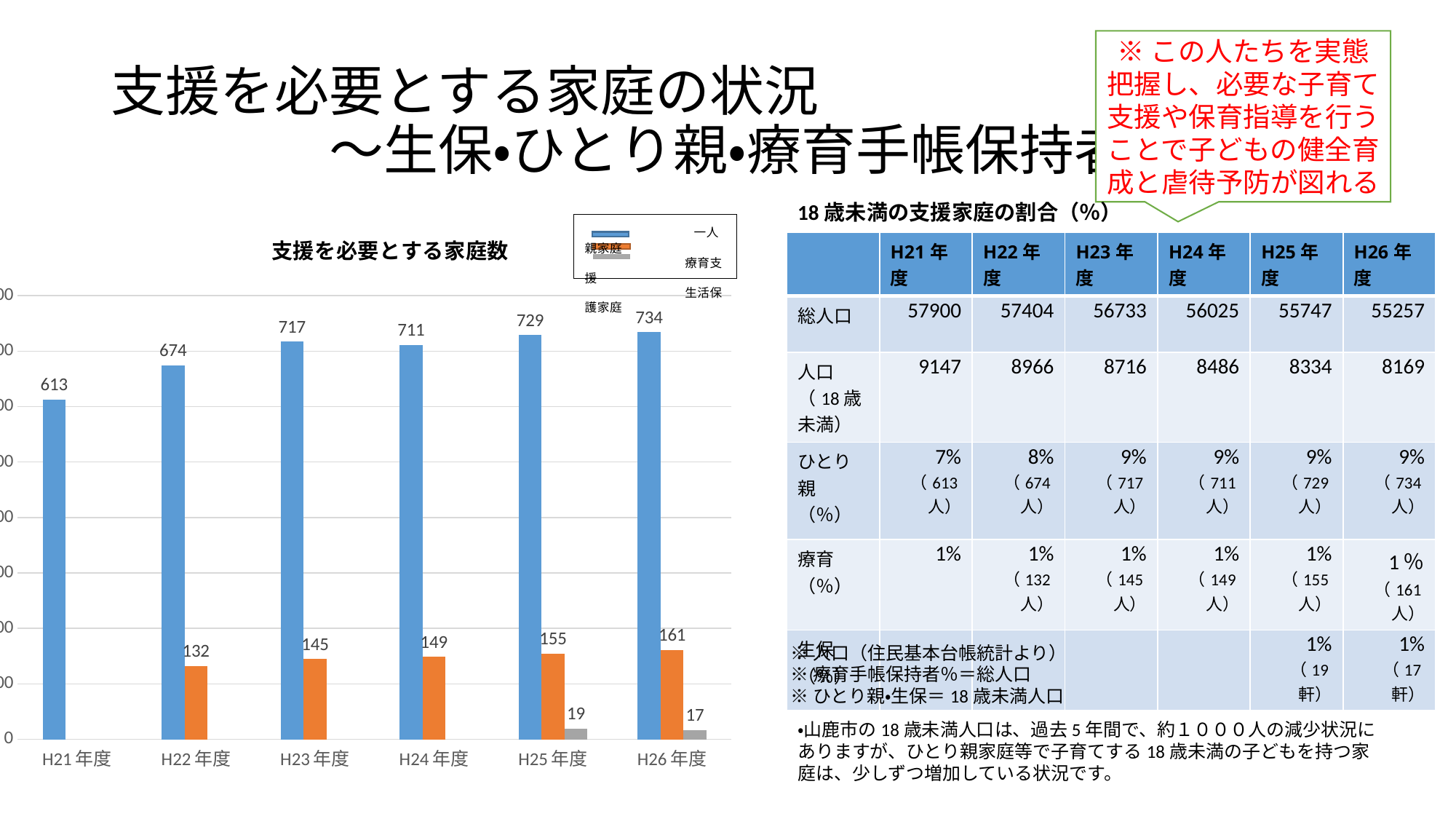
Does the orange (療育支援) series rise or fall from H22年度 to H26年度? rise What is the value of the blue (一人親家庭) bar for H21年度? 613 What is the value of the orange (療育支援) bar for H24年度? 149 Which year has the lowest value for the blue (一人親家庭) series? H21年度 Which year has the highest value for the blue (一人親家庭) series? H26年度 How many series does the chart legend list? 3 What is the difference between the blue (一人親家庭) values for H26年度 and H21年度? 121 What is the title of the bar chart? 支援を必要とする家庭数 What is the value of the gray (生活保護家庭) bar for H25年度? 19 Which is larger, the blue (一人親家庭) value for H23年度 or for H24年度? H23年度 How many year categories are shown on the x axis of the chart? 6 What type of chart is shown on the slide? bar chart